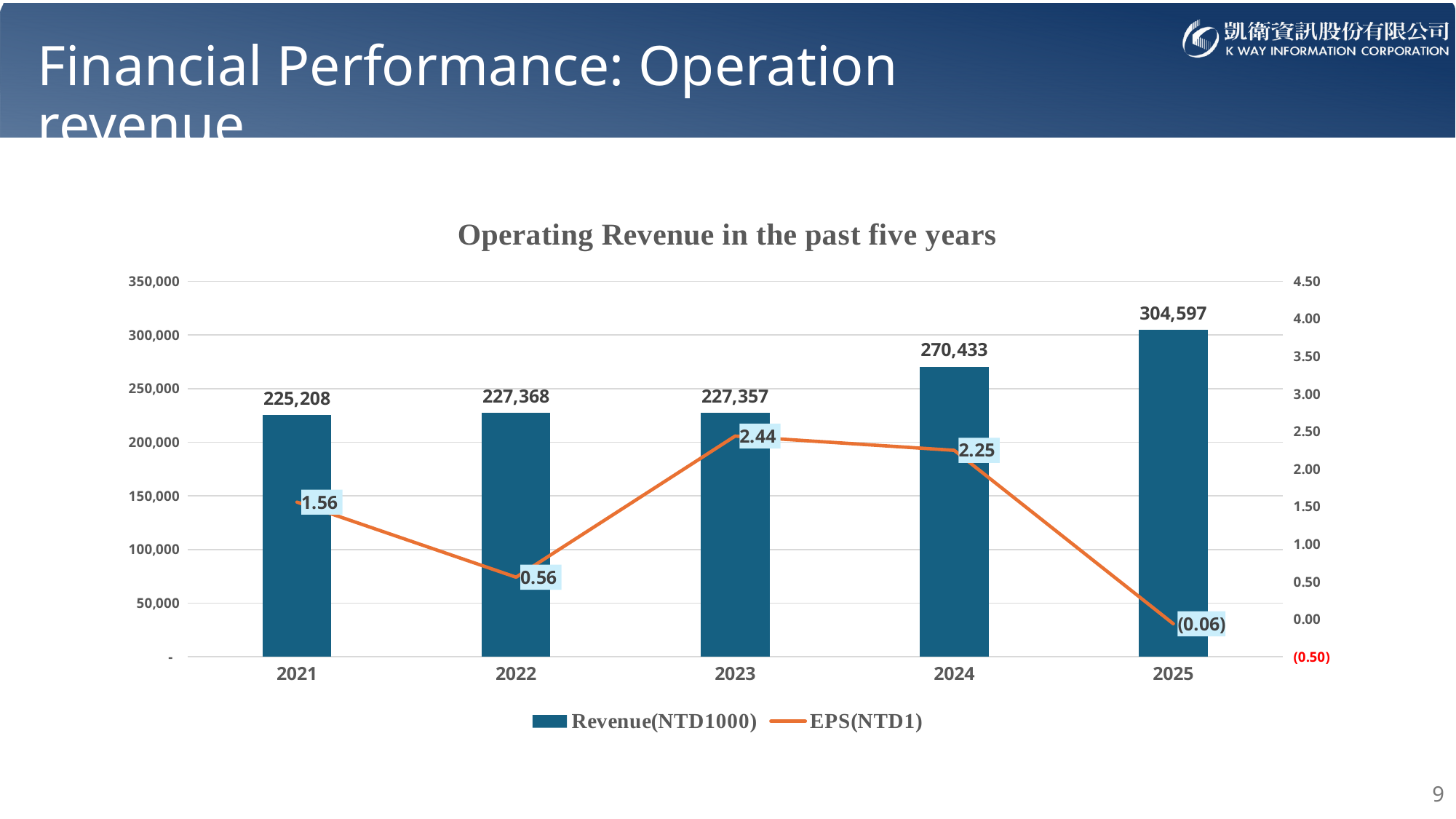
Which year has the lowest EPS(NTD1)? 2025 Which year has the highest Revenue(NTD1000)? 2025 Which year has the higher EPS(NTD1), 2021 or 2022? 2021 What is the difference in Revenue(NTD1000) between 2025 and 2024? 34,164 How many years are shown on the x axis? 5 What is the title of the chart? Operating Revenue in the past five years What kind of chart is used to show Revenue(NTD1000)? Bar chart What is the EPS(NTD1) value for 2023? 2.44 What is the Revenue(NTD1000) value for 2025? 304,597 How many series does the legend list? 2 Is the Revenue(NTD1000) value for 2024 greater or less than 250,000? greater What is the EPS(NTD1) value for 2025? (0.06)